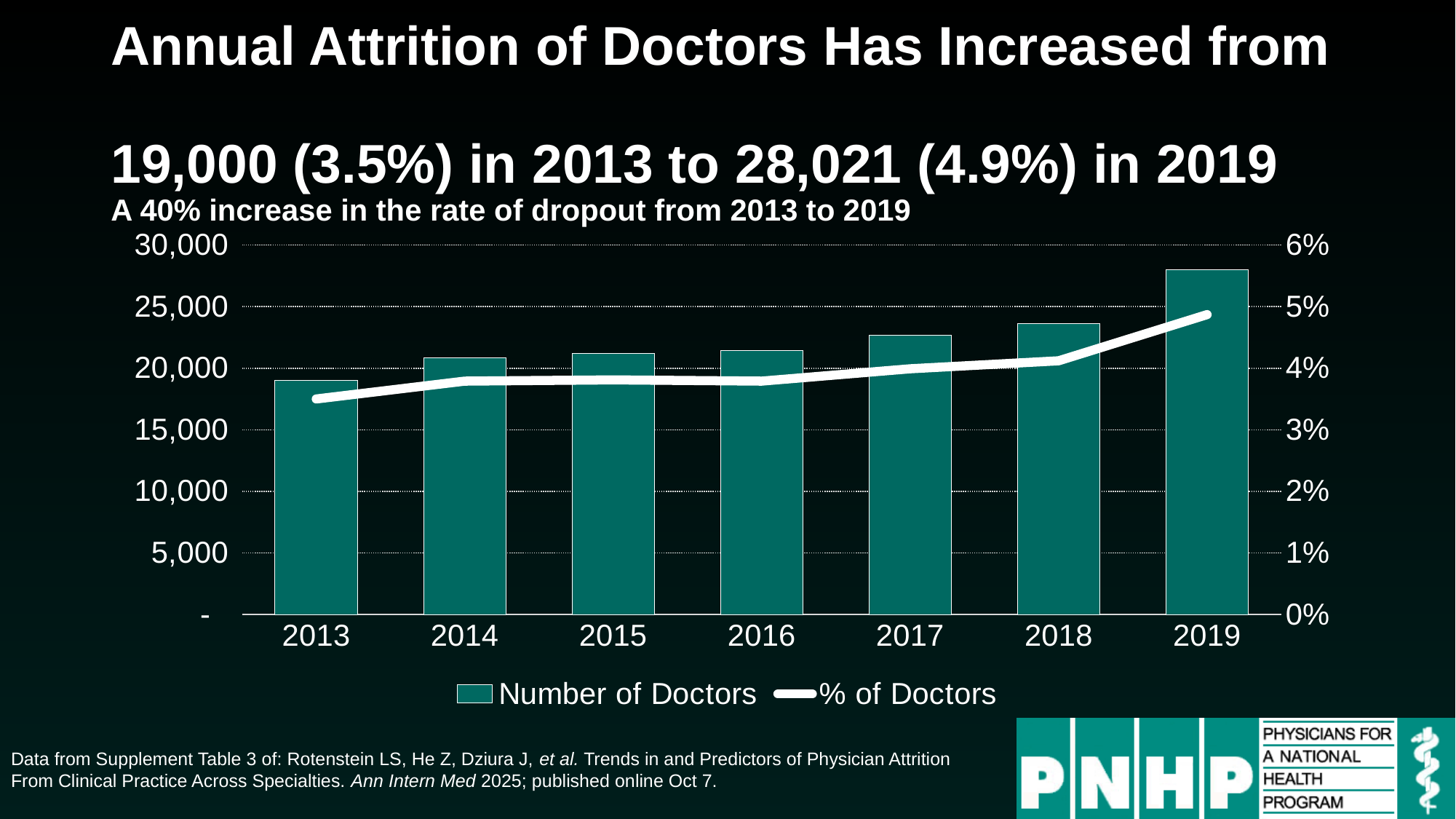
Is the % of doctors for 2018 greater or less than 5%? less Which year has the lowest number of doctors leaving? 2013 What was the attrition rate (% of doctors) in 2019? 4.9% How many series does the chart's legend list? 2 Which year has the highest number of doctors leaving? 2019 By how much did the number of doctors leaving increase from 2013 to 2019? 9,021 What was the number of doctors leaving in 2013? 19,000 Is the number of doctors for 2016 greater or less than 20,000? greater Does the % of doctors line rise or fall from 2013 to 2019? Rises How many years are shown along the x axis of the chart? 7 What kind of chart is shown on the slide? A bar chart with a line Which year has the larger number of doctors, 2015 or 2018? 2018